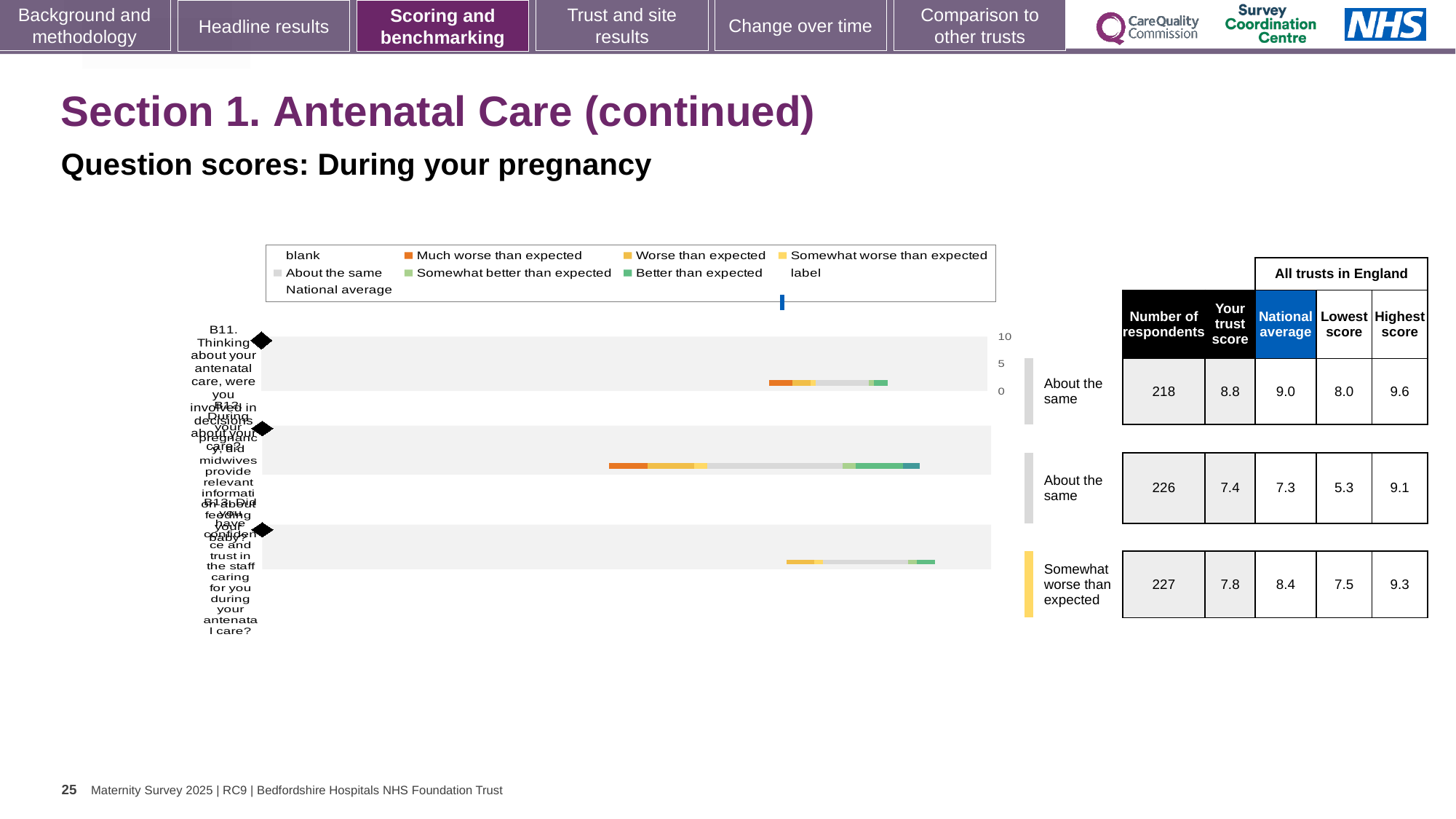
What is the national average for question B13? 8.4 How many questions (rows) are plotted in the chart? 3 How many entries does the chart legend list? 9 What kind of chart is shown on the slide? bar chart What is the trust score for question B12? 7.4 Which question has the lowest 'Lowest score' across all trusts in England? B12 What is the number of respondents for question B11? 218 What rating category is shown for question B13? Somewhat worse than expected What is the difference between the national average and the trust score for question B13? 0.6 Which question has the highest trust score? B11 For question B11, which is larger: the trust score or the national average? national average